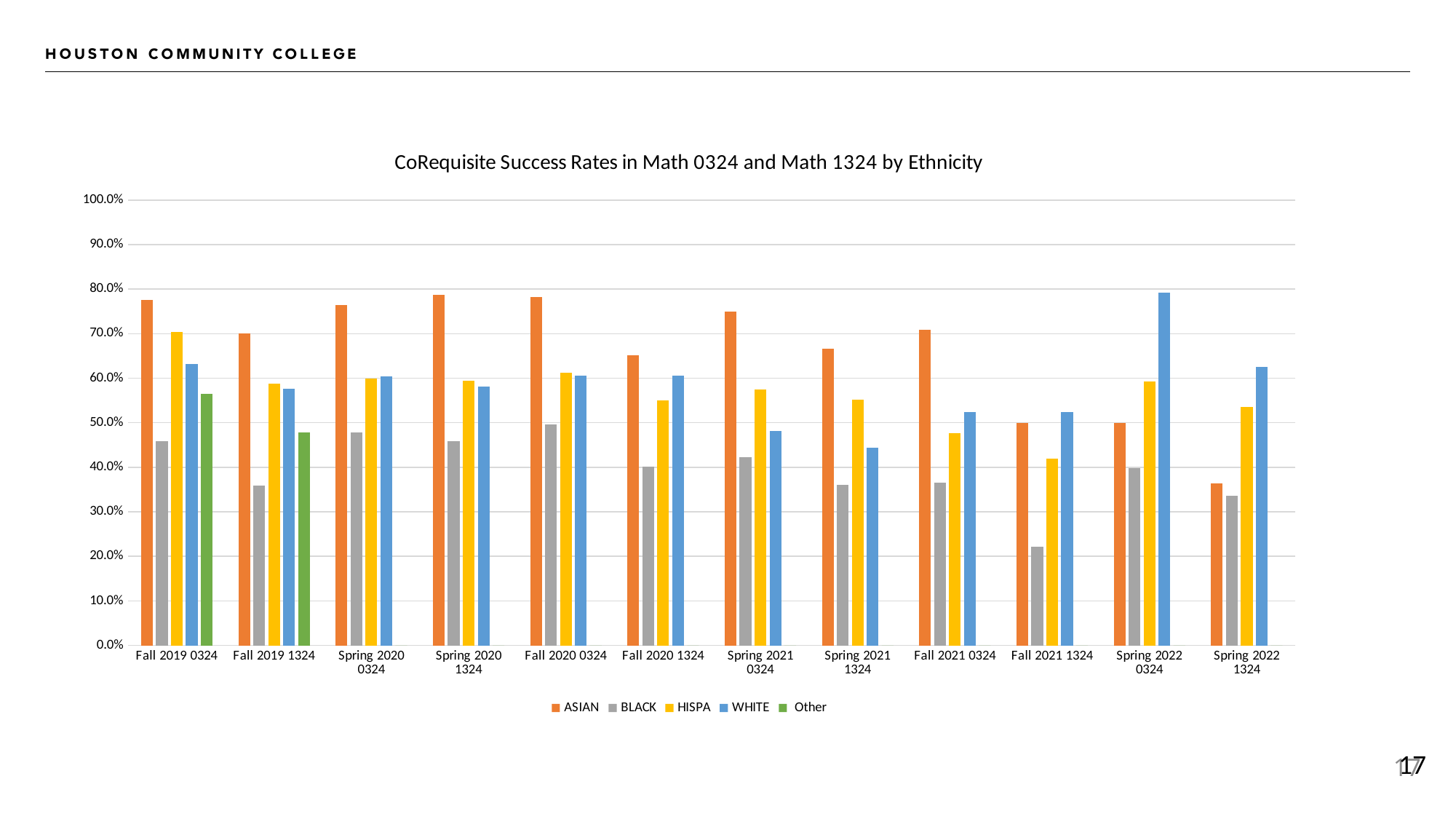
Is the ASIAN value for Spring 2020 1324 greater or less than 70.0%? greater How many term/course categories are shown along the x axis? 12 For Fall 2019 0324, which is larger, the ASIAN value or the BLACK value? ASIAN In which category is the BLACK series at its lowest? Fall 2021 1324 What type of chart is shown on the slide? Bar chart In which category is the ASIAN series at its lowest? Spring 2022 1324 Which series is shown in green in the legend? Other How many series does the legend list? 5 For Spring 2022 1324, which is larger, the HISPA value or the WHITE value? WHITE Is the BLACK value for Fall 2021 1324 greater or less than 30.0%? less In which category is the WHITE series at its highest? Spring 2022 0324 Is the WHITE value for Spring 2022 0324 greater or less than 70.0%? greater